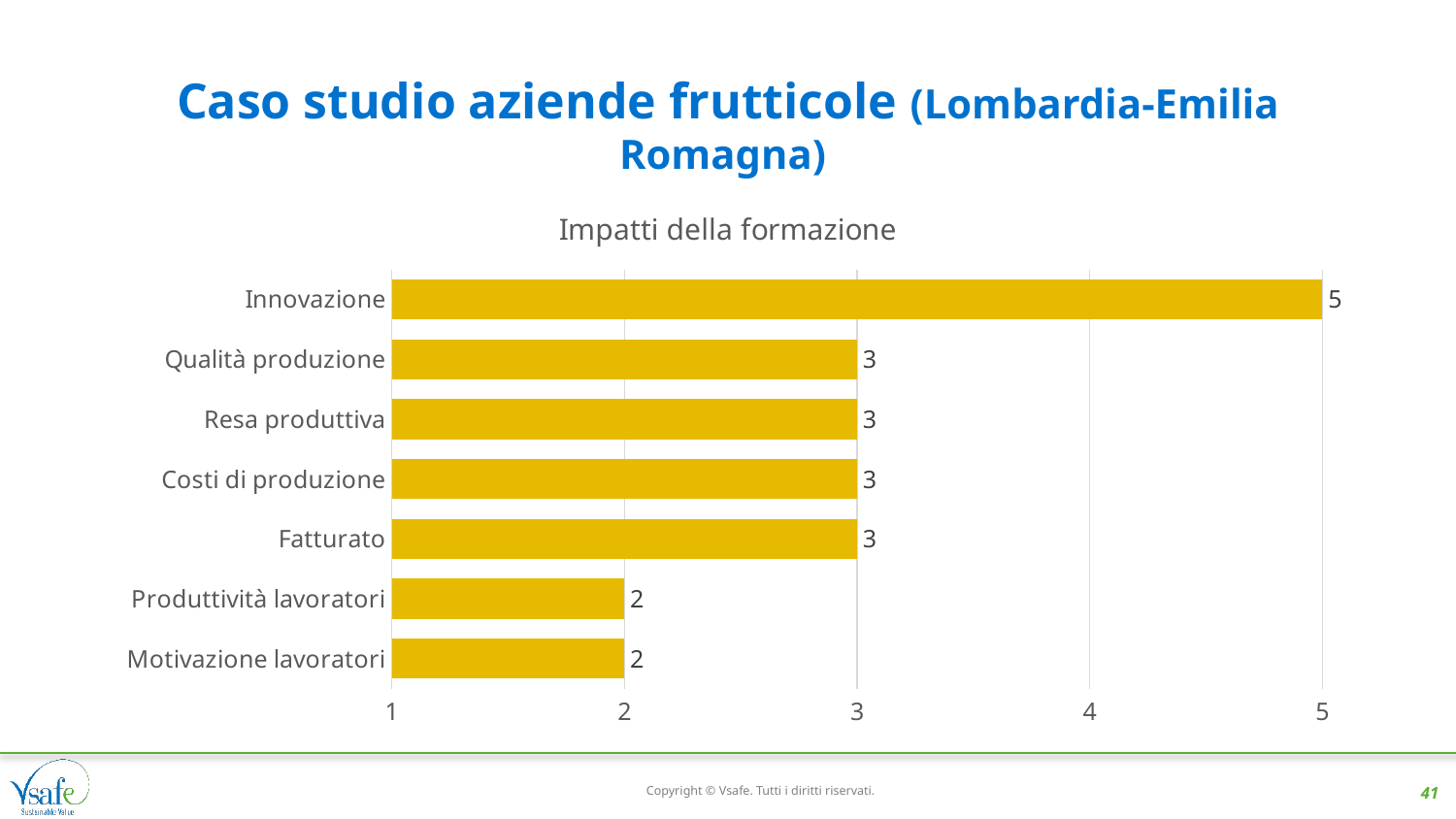
Is the value for Innovazione greater or less than 4? greater What is the value for Motivazione lavoratori? 2 Which category has the highest value? Innovazione What is the difference between the values for Innovazione and Produttività lavoratori? 3 How many categories are shown in the chart? 7 What is the value for Resa produttiva? 3 What is the title of the chart? Impatti della formazione What kind of chart is shown on the slide? bar chart What is the value for Fatturato? 3 What is the value for Innovazione? 5 What is the difference between the values for Qualità produzione and Motivazione lavoratori? 1 Which is larger, the value for Costi di produzione or the value for Produttività lavoratori? Costi di produzione